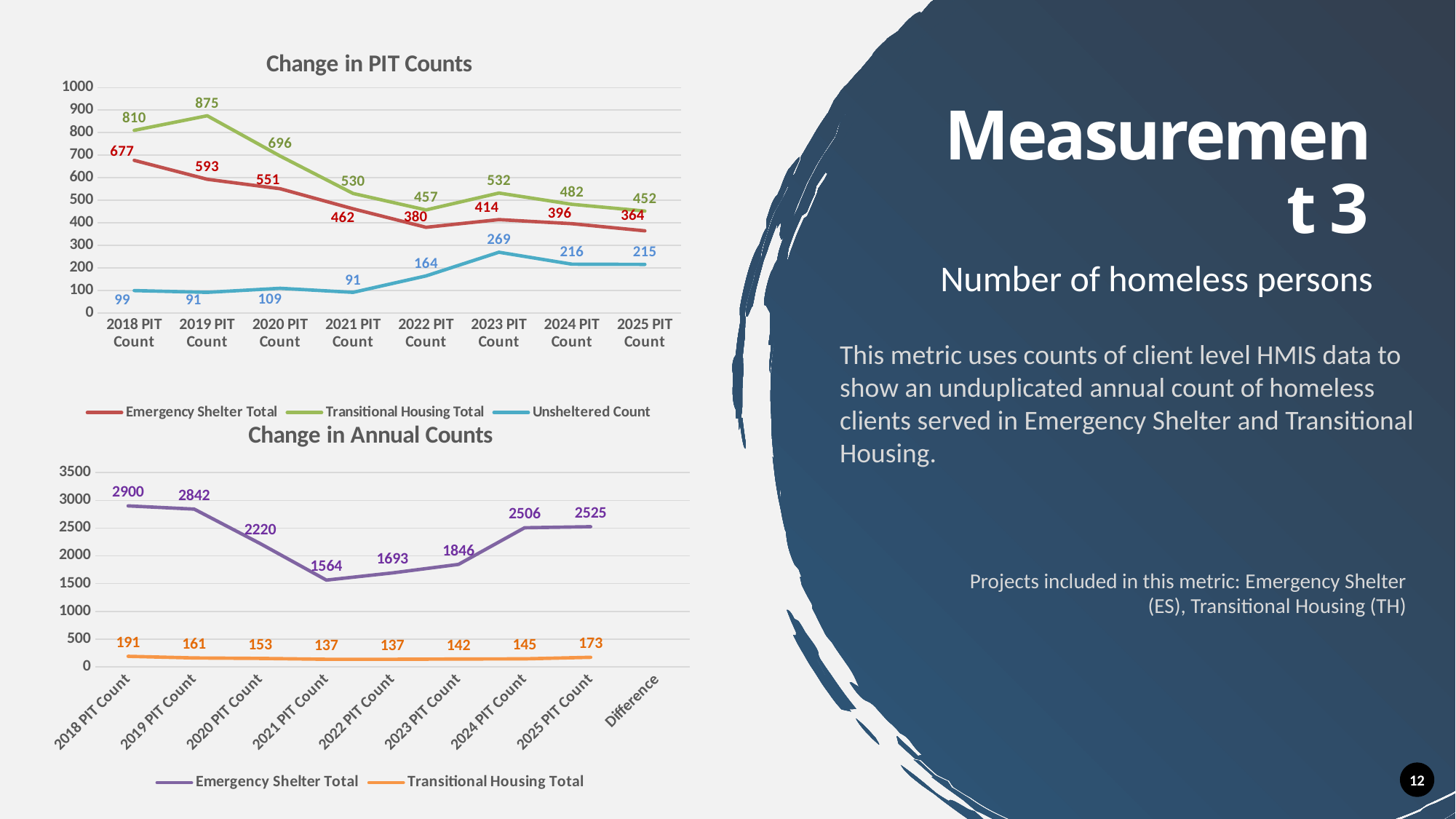
In the 'Change in Annual Counts' chart, which PIT Count has the highest Emergency Shelter Total? 2018 PIT Count What kind of chart is 'Change in PIT Counts'? Line chart In the 'Change in PIT Counts' chart, what is the Emergency Shelter Total for the 2018 PIT Count? 677 In the 'Change in Annual Counts' chart, how many series does the legend list? 2 In the 'Change in PIT Counts' chart, which PIT Count has the highest Transitional Housing Total? 2019 PIT Count In the 'Change in Annual Counts' chart, what is the Transitional Housing Total for the 2025 PIT Count? 173 In the 'Change in PIT Counts' chart, which PIT Count has the lowest Unsheltered Count? 2019 PIT Count and 2021 PIT Count (both 91) In the 'Change in PIT Counts' chart, how many series does the legend list? 3 In the 'Change in Annual Counts' chart, is the Emergency Shelter Total for the 2024 PIT Count greater or less than the Transitional Housing Total for the same count? greater In the 'Change in PIT Counts' chart, what is the difference between the Transitional Housing Total and the Emergency Shelter Total for the 2025 PIT Count? 88 In the 'Change in PIT Counts' chart, what is the Unsheltered Count for the 2023 PIT Count? 269 In the 'Change in Annual Counts' chart, what is the Emergency Shelter Total for the 2021 PIT Count? 1564